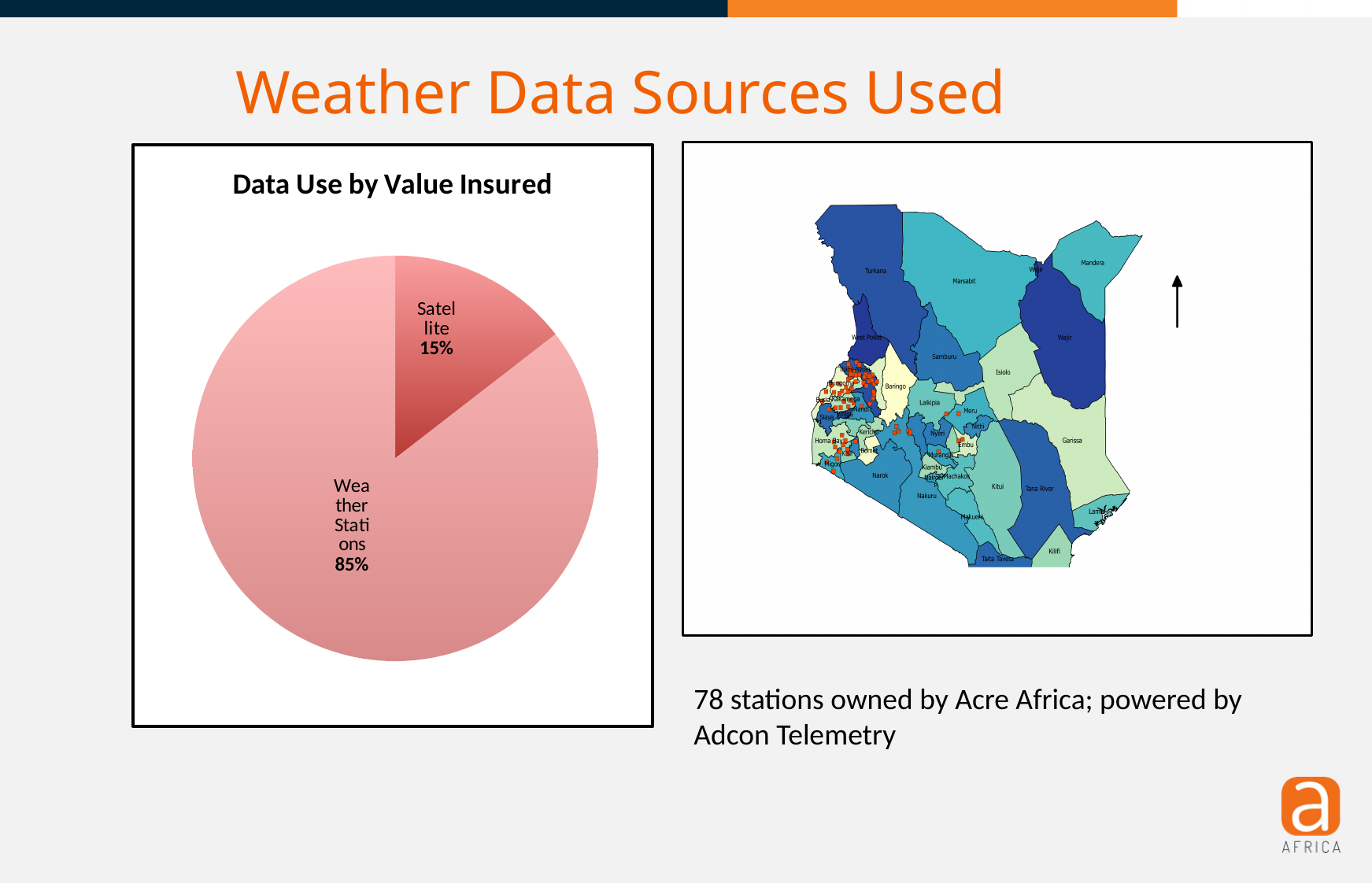
What is the total of the two slices in the pie chart? 100% Which slice of the pie chart is the largest? Weather Stations Is the value for Satellite greater or less than 50%? less What share of the pie does Weather Stations account for? 85% What share of the pie does Satellite account for? 15% Which is larger in the pie chart, Satellite or Weather Stations? Weather Stations Which slice of the pie chart is the smallest? Satellite What kind of chart is "Data Use by Value Insured"? pie chart How many slices does the pie chart have? 2 What is the title of the pie chart? Data Use by Value Insured What is the difference in percentage points between the Weather Stations and Satellite slices? 70